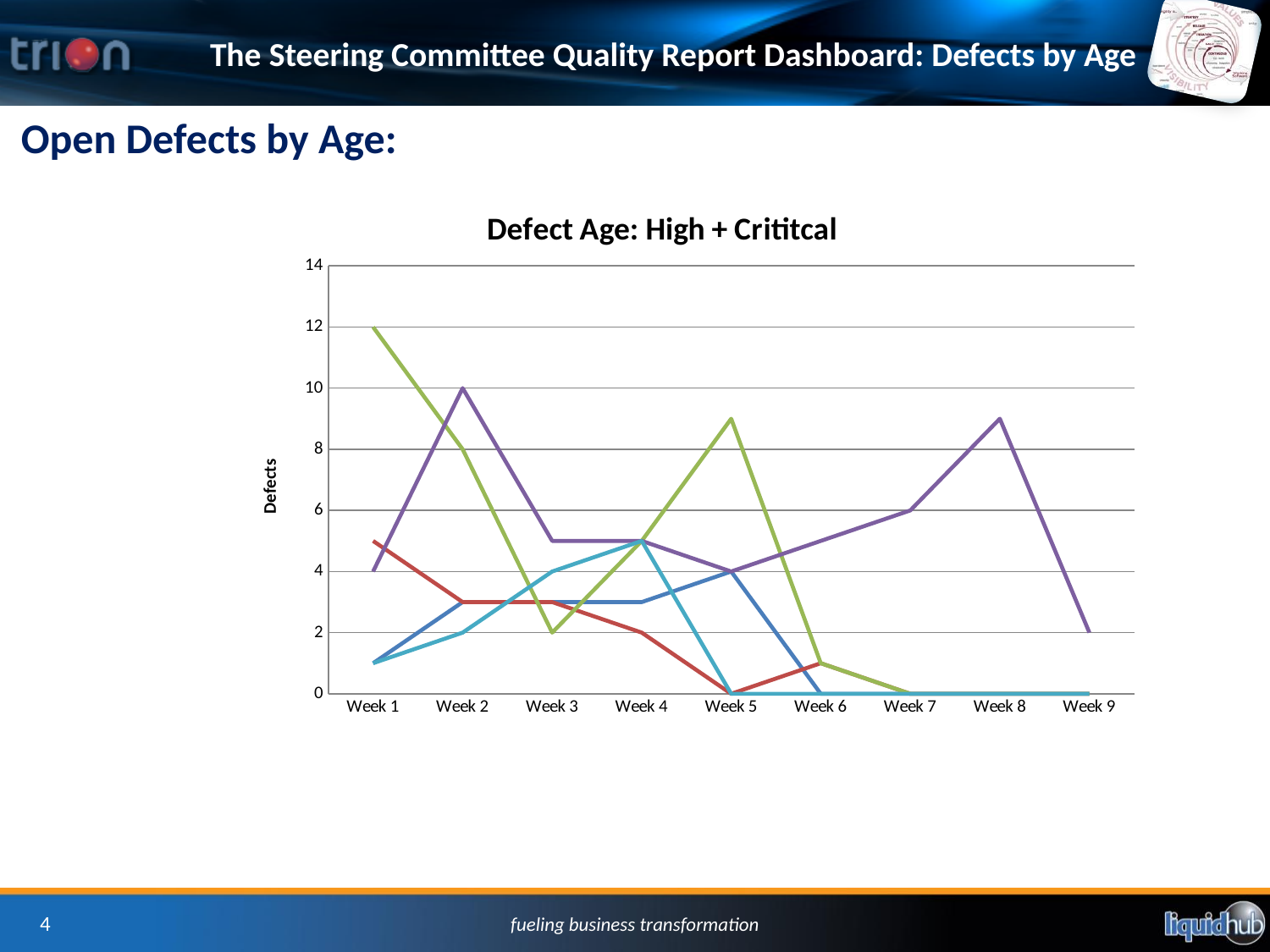
Does the green line rise or fall from Week 5 to Week 7? fall What is the label on the vertical axis of the chart? Defects What is the value of the green line at Week 1? 12 How many weeks are shown along the x axis of the chart? 9 At Week 1, which line has the larger value, the green line or the purple line? green line Is the value of the green line at Week 3 greater or less than 4? less What is the value of the purple line at Week 2? 10 What is the highest value plotted on the chart, and in which week does it occur? 12, Week 1 What is the title of the chart? Defect Age: High + Crititcal What type of chart is shown on the slide? line chart Is the value of the purple line at Week 8 greater or less than 8? greater